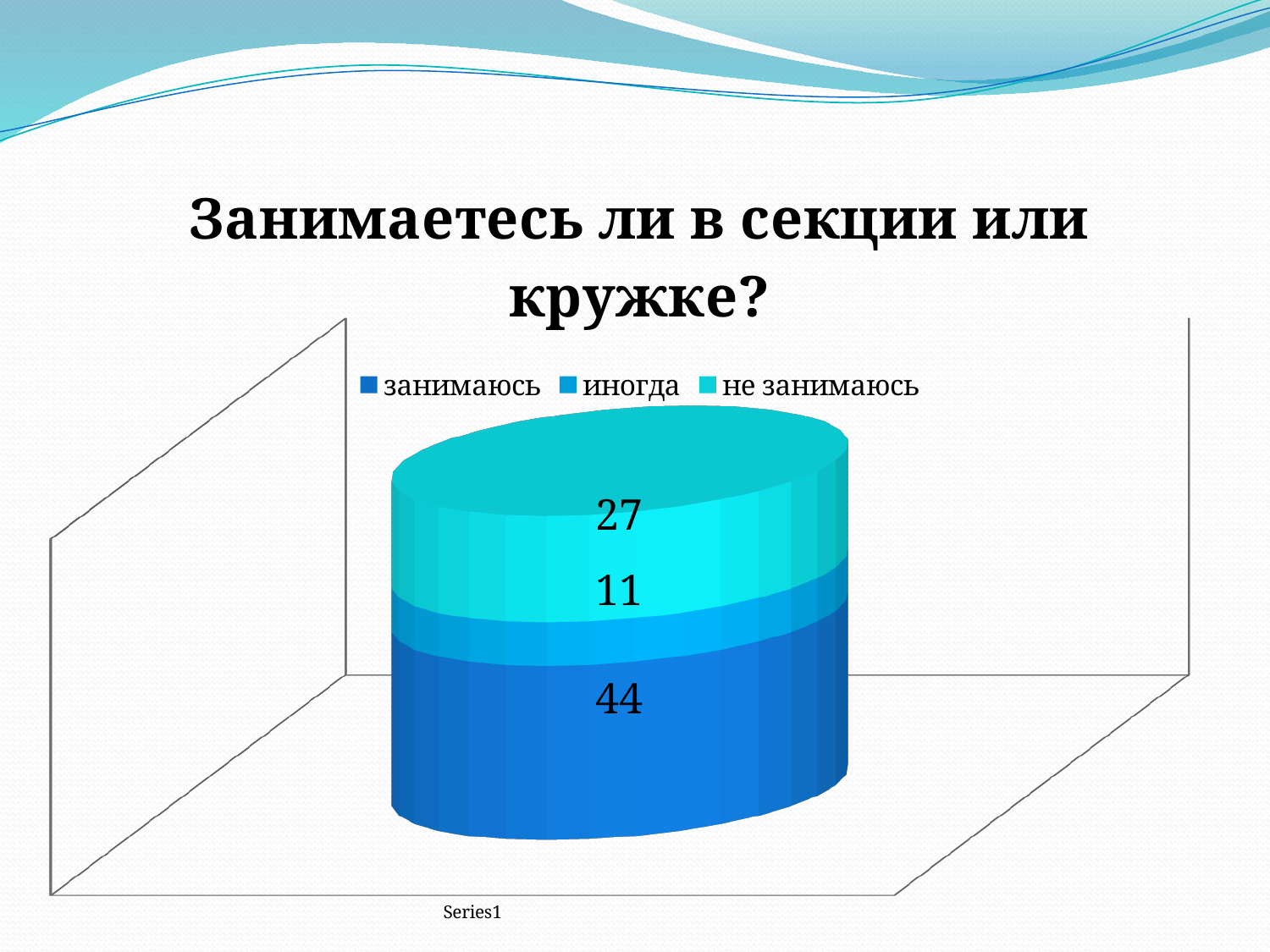
What is the total of the stacked bar in the chart? 82 How many series does the legend list? 3 What is the difference between the values for "не занимаюсь" and "иногда"? 16 What is the difference between the values for "занимаюсь" and "не занимаюсь"? 17 What is the value for "иногда" in the chart? 11 What is the value for "не занимаюсь" in the chart? 27 What kind of chart is shown on the slide? Stacked bar chart Which series has the highest value in the chart? занимаюсь What is the title of the chart? Занимаетесь ли в секции или кружке? Which series has the lowest value in the chart? иногда What is the value for "занимаюсь" in the chart? 44 Which is larger, the value for "не занимаюсь" or the value for "иногда"? не занимаюсь